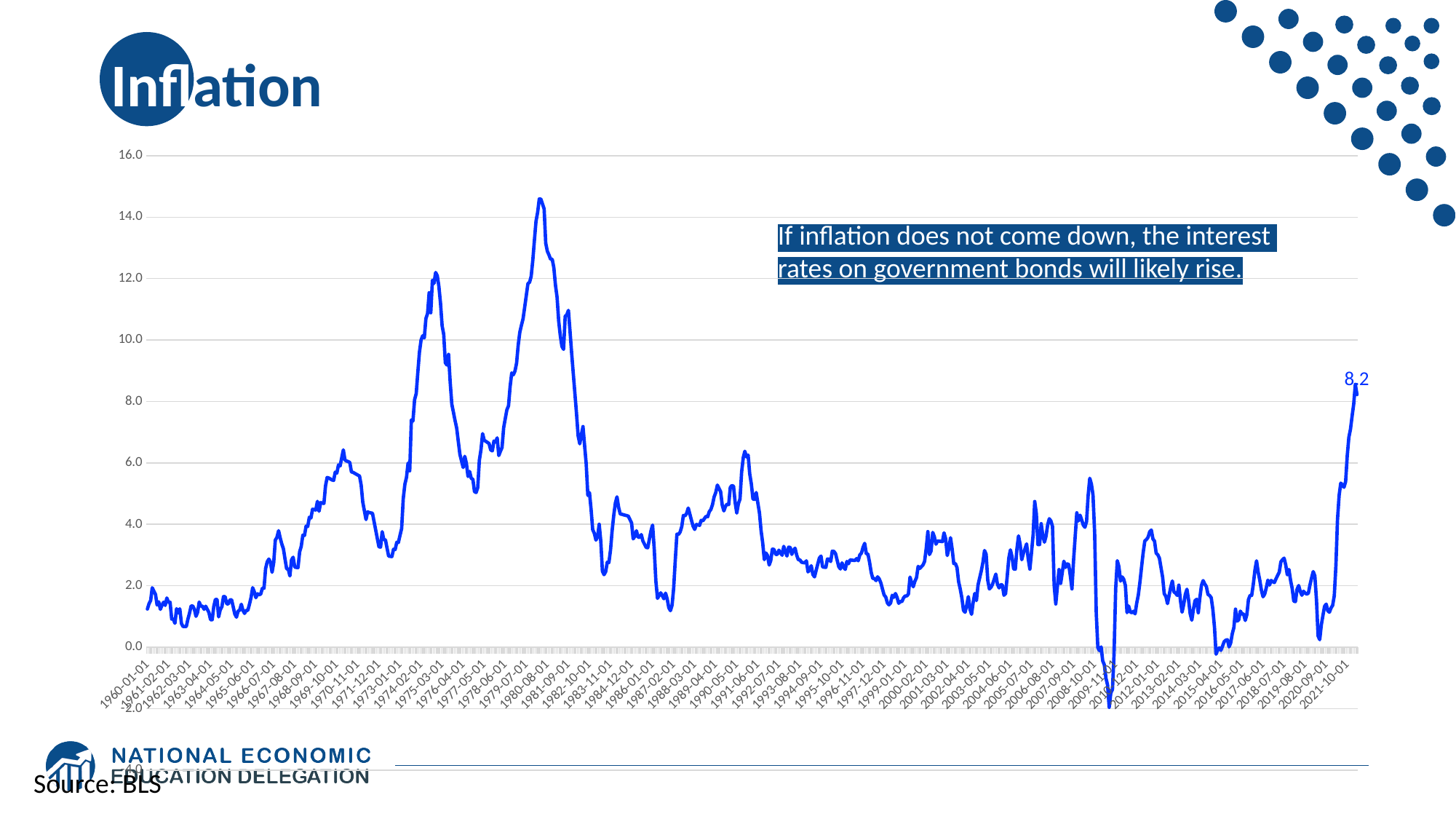
Is the lowest point of the line, around 2009, greater or less than 0.0? less Which is higher: the peak around 1980 or the peak around 1975? the peak around 1980 What is the title of the chart on the slide? Inflation How many data series are plotted on the chart? 1 Is the highest peak of the line, around 1980, greater or less than 14.0? greater Does the line rise or fall between 2020 and the end of the series in 2021? rise Around which year does the line reach its highest value? 1980 Is the peak of the line around 1975 greater or less than 10.0? greater What source is cited for the chart data? BLS What kind of chart is shown on the slide? line chart What is the value of the data label shown at the end of the line, at the most recent point? 8.2